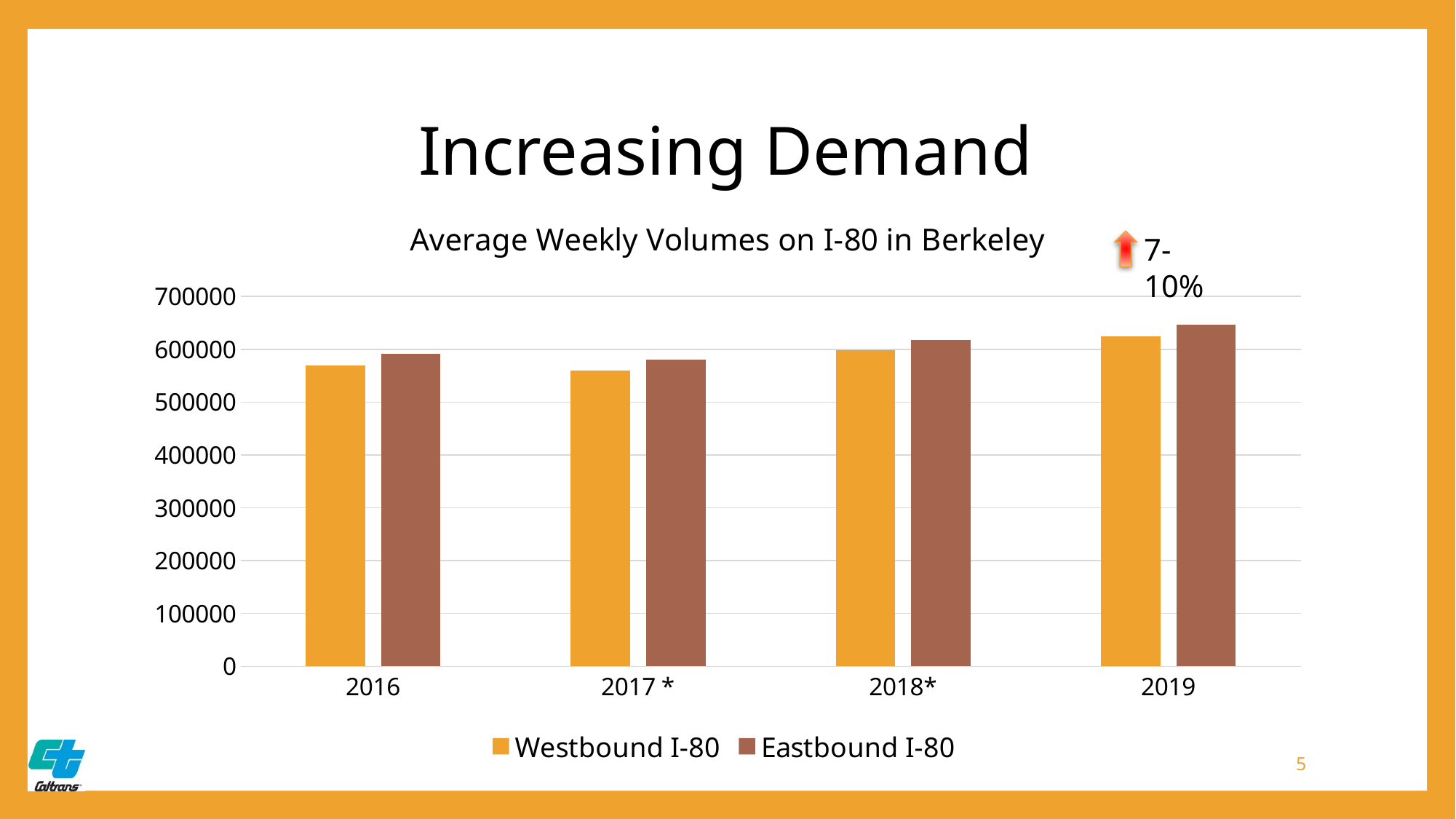
How many years are shown on the x axis? 4 Which is larger, Eastbound I-80 in 2019 or Westbound I-80 in 2017 *? Eastbound I-80 in 2019 Which year has the highest Eastbound I-80 value? 2019 What type of chart is shown on the slide? bar chart From 2017 * to 2019, do the Westbound I-80 values rise or fall? rise Which is larger in 2016, Westbound I-80 or Eastbound I-80? Eastbound I-80 How many series does the legend list? 2 What is the title of the chart? Average Weekly Volumes on I-80 in Berkeley Is the Eastbound I-80 value for 2019 greater or less than 600000? greater Is the Westbound I-80 value for 2016 greater or less than 600000? less Is the Westbound I-80 value for 2019 greater or less than 600000? greater Which year has the lowest Westbound I-80 value? 2017 *